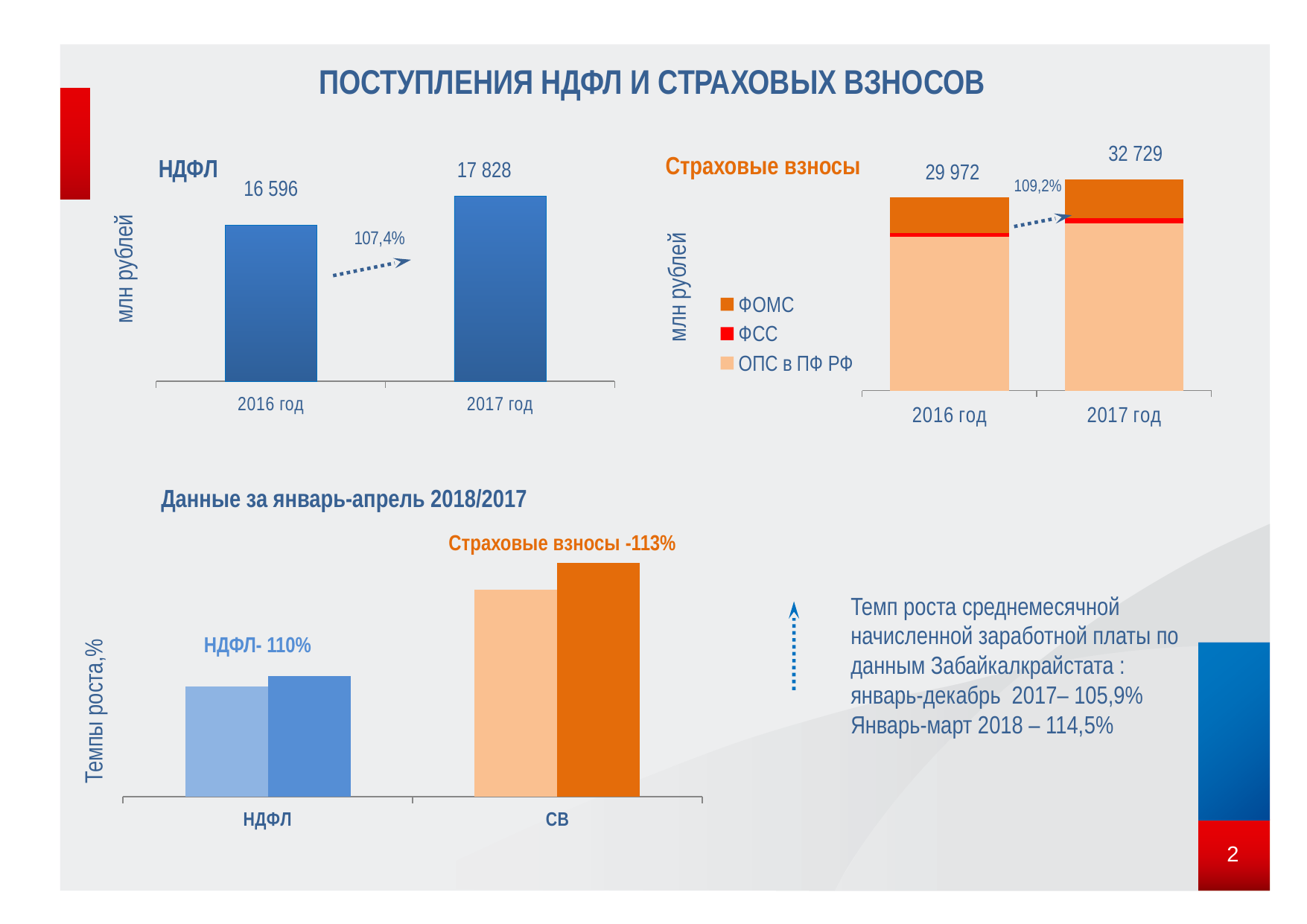
In the НДФЛ chart (top left), what is the value for 2017 год? 17 828 In the НДФЛ chart (top left), what growth percentage is shown on the arrow between the two bars? 107,4% What kind of chart is the Страховые взносы chart (top right)? Stacked bar chart In the Страховые взносы chart (top right), which year has the larger total, 2016 год or 2017 год? 2017 год In the Страховые взносы chart (top right), what is the total for the 2016 год bar? 29 972 How many series does the legend of the Страховые взносы chart (top right) list? 3 In the НДФЛ chart (top left), what is the difference between the 2017 год and 2016 год values? 1 232 How many categories are shown on the x axis of the bottom chart (Данные за январь-апрель 2018/2017)? 2 In the Страховые взносы chart (top right), what is the difference between the 2017 год and 2016 год totals? 2 757 In the bottom chart (Данные за январь-апрель 2018/2017), what growth rate is labelled for Страховые взносы? 113% In the Страховые взносы chart (top right), what is the total for the 2017 год bar? 32 729 In the НДФЛ chart (top left), what is the value for 2016 год? 16 596